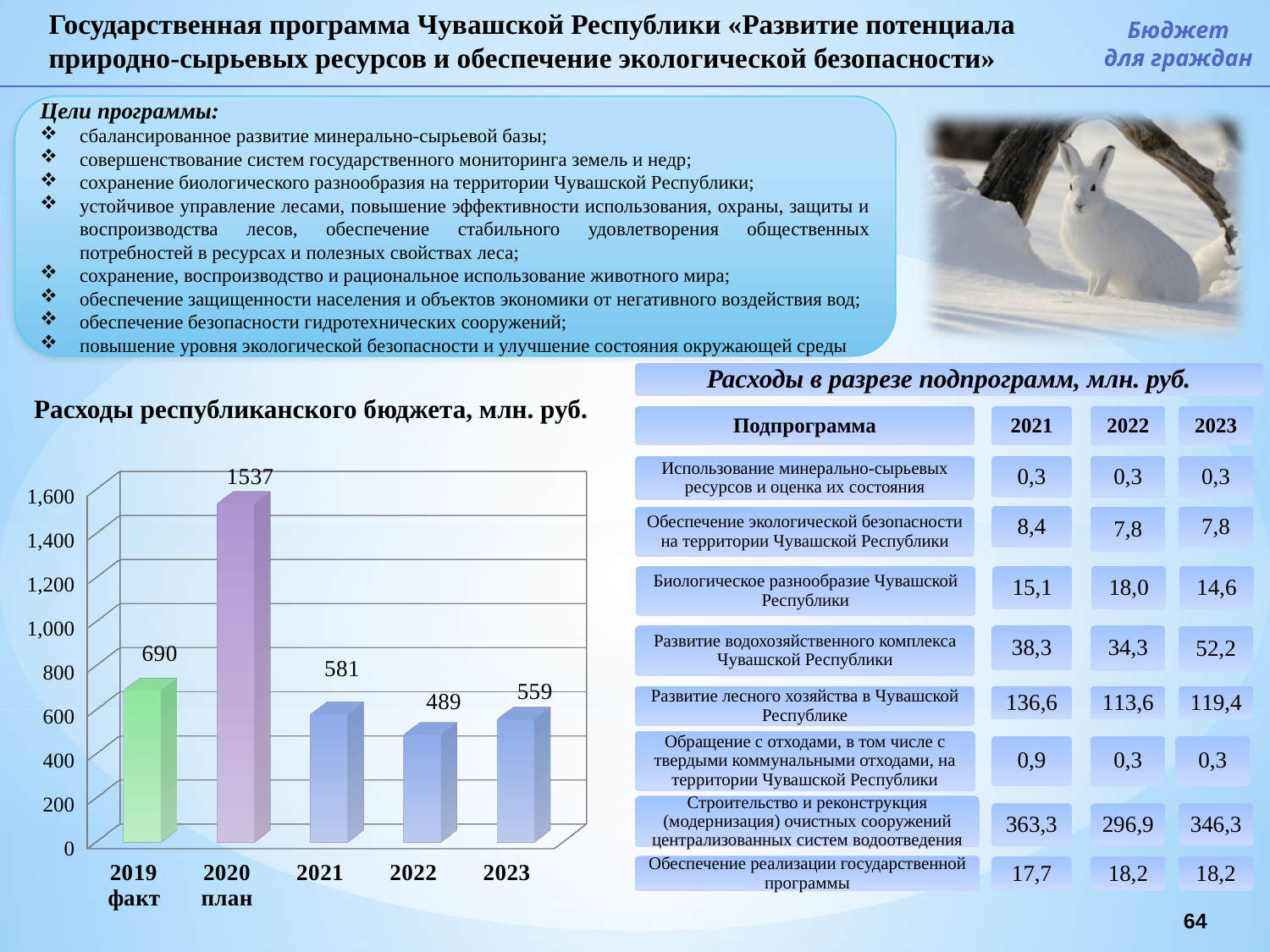
What is the difference between the values for 2020 план and 2021? 956 What is the title of the chart on the left of the slide? Расходы республиканского бюджета, млн. руб. What is the value for 2019 факт in the chart? 690 What is the difference between the values for 2023 and 2022? 70 What is the value for 2020 план in the chart 'Расходы республиканского бюджета, млн. руб.'? 1537 Which category has the lowest value in the chart? 2022 How many categories are shown on the x axis of the chart? 5 What kind of chart is 'Расходы республиканского бюджета, млн. руб.'? bar chart What is the value for 2022 in the chart? 489 Which category has the highest value in the chart? 2020 план What is the value for 2023 in the chart? 559 Which is larger, the value for 2019 факт or the value for 2021? 2019 факт